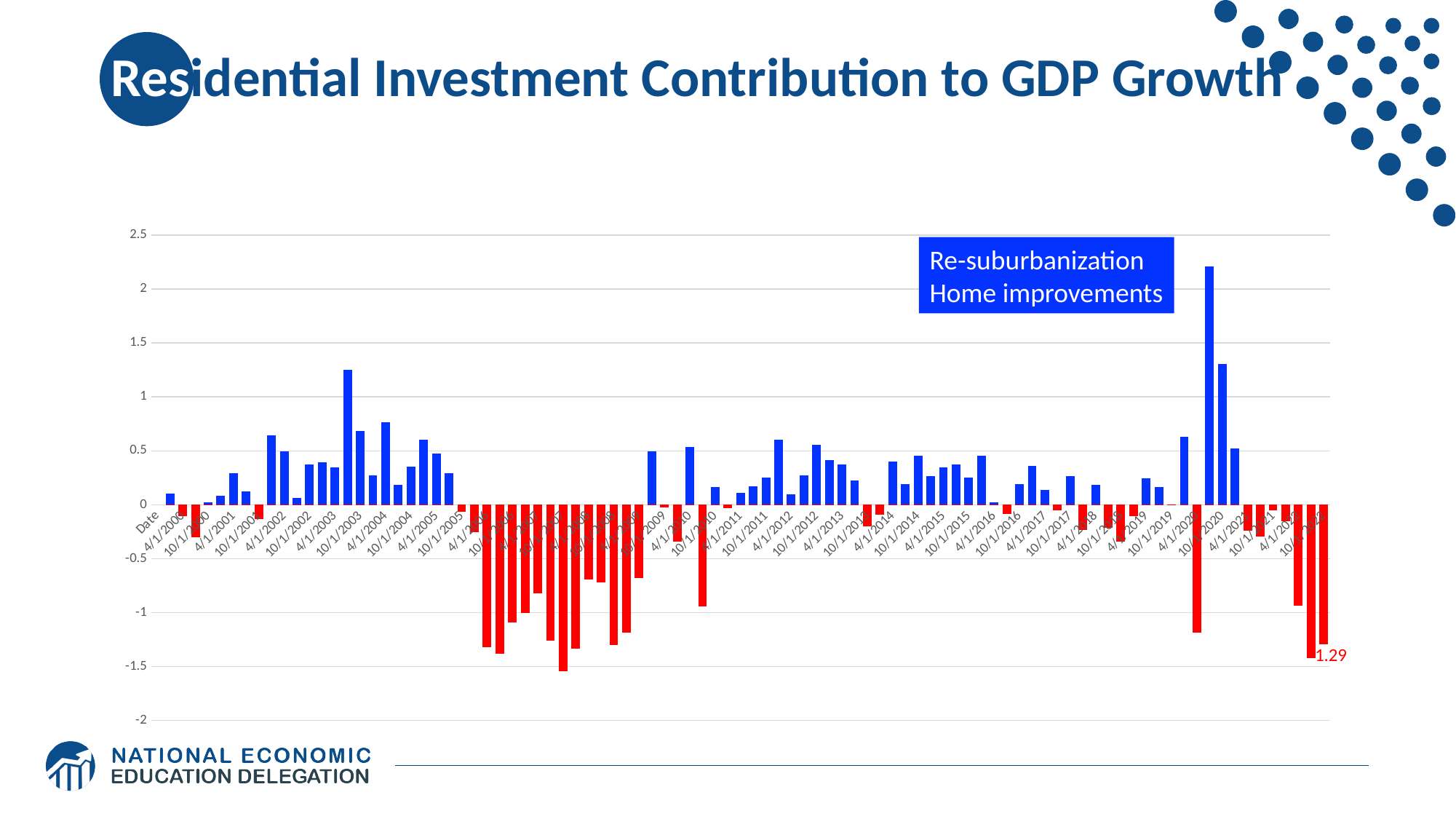
What is the title of the slide's chart? Residential Investment Contribution to GDP Growth Which is larger: the tallest bar around 2020 or the tallest bar around 2003? the tallest bar around 2020 What is the highest value shown on the vertical axis? 2.5 What kind of chart is shown on the slide? bar chart Is the tallest positive bar on the chart greater or less than 2? greater Is the lowest negative bar on the chart greater or less than -1.5? less Are the bars for the quarters from 2006 through 2008 mostly positive or negative? negative What text appears in the blue annotation box on the chart? Re-suburbanization Home improvements Is the bar near 4/1/2012 greater or less than 1? less